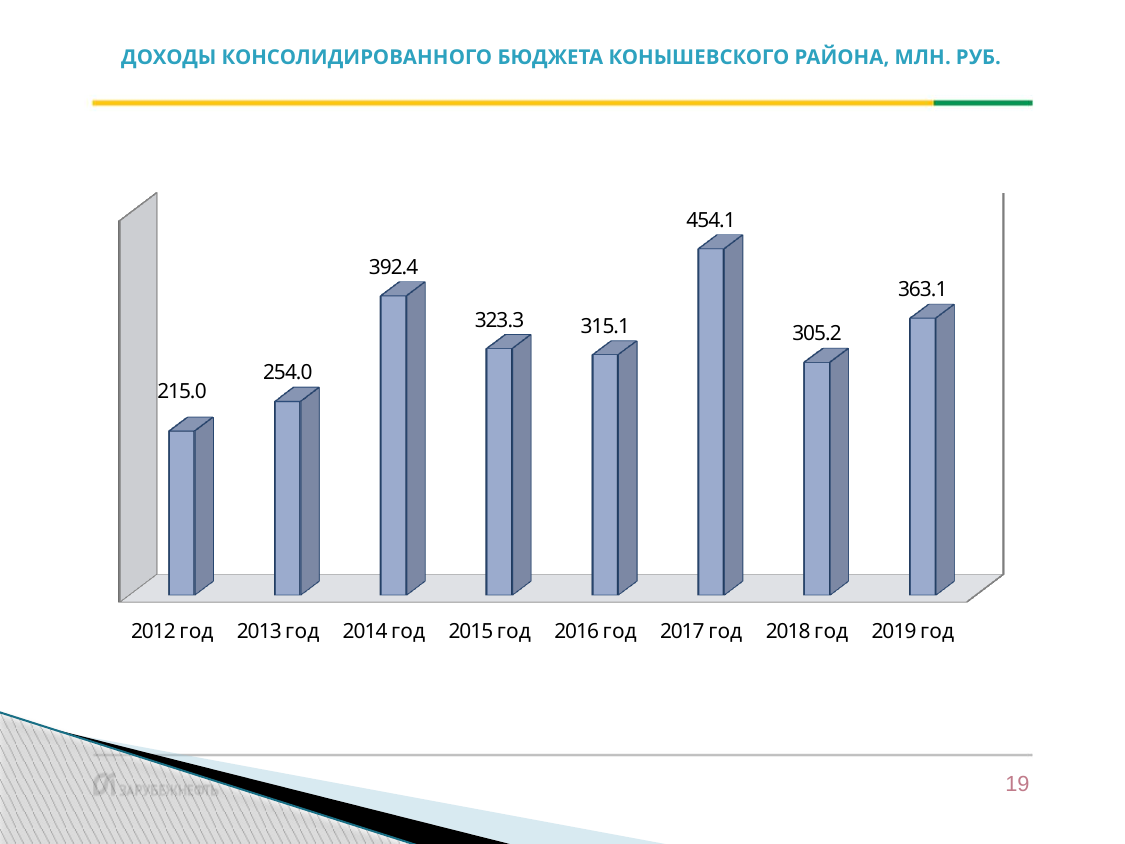
What is the value for 2012 год? 215.0 What is the value for 2017 год? 454.1 Which year has the highest value? 2017 год What is the value for 2019 год? 363.1 What is the difference between the values for 2017 год and 2018 год? 148.9 Which year has the lowest value? 2012 год What kind of chart is shown on the slide? bar chart Which is larger, the value for 2014 год or the value for 2019 год? 2014 год Do the values rise or fall from 2012 год to 2014 год? rise What is the title of the chart? ДОХОДЫ КОНСОЛИДИРОВАННОГО БЮДЖЕТА КОНЫШЕВСКОГО РАЙОНА, МЛН. РУБ. How many years are shown on the chart? 8 What is the difference between the values for 2013 год and 2012 год? 39.0